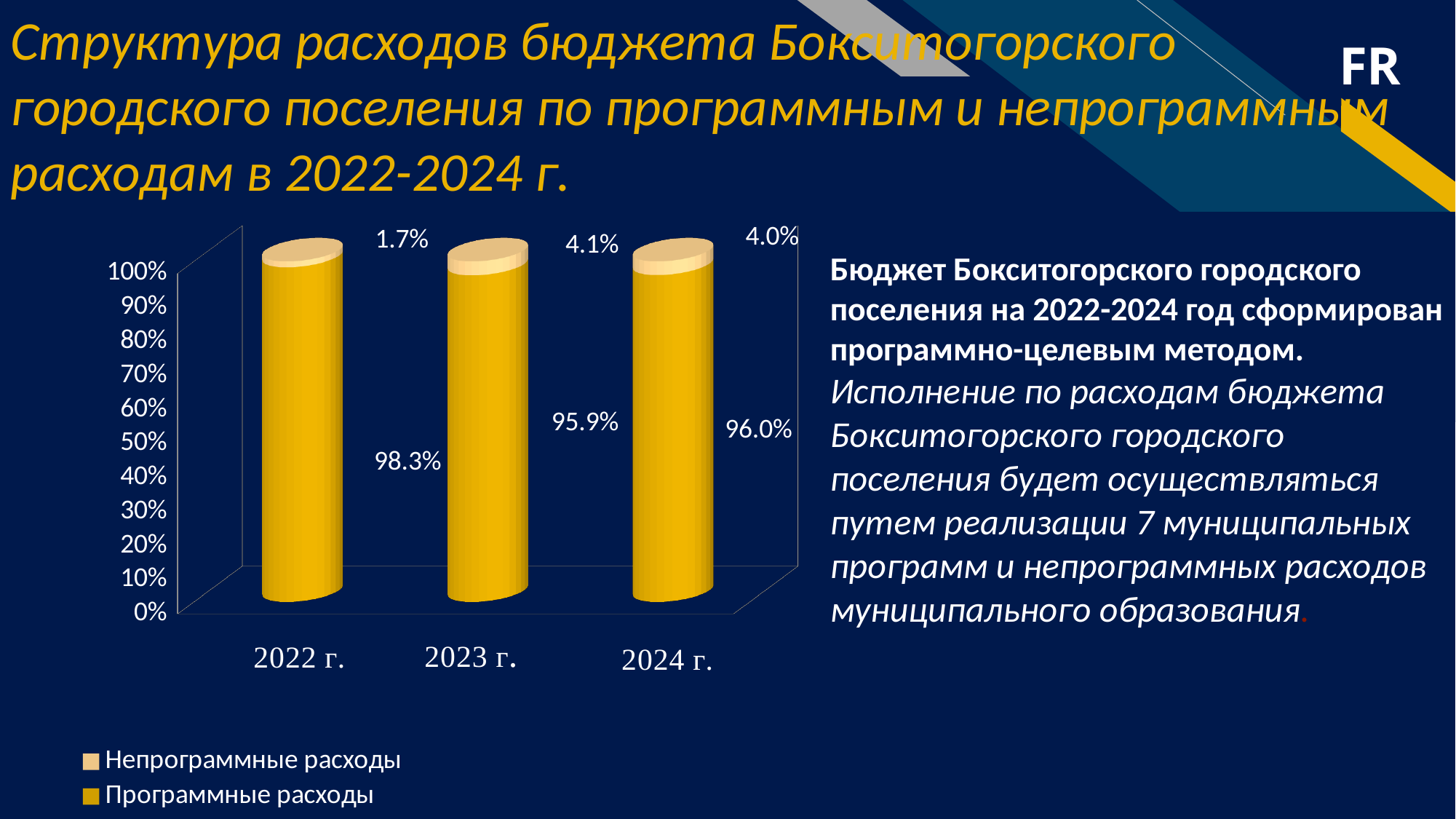
In which year is the share of Непрограммные расходы highest? 2023 г. What kind of chart is shown on the slide? Stacked bar chart How many years are shown on the x axis of the chart? 3 In which year is the share of Программные расходы lowest? 2023 г. What is the value for Непрограммные расходы in 2022 г.? 1.7% What is the value for Программные расходы in 2024 г.? 96.0% What is the total of the stacked bar for 2023 г.? 100% What is the value for Программные расходы in 2022 г.? 98.3% What is the value for Непрограммные расходы in 2023 г.? 4.1% Which is larger: Непрограммные расходы in 2022 г. or in 2024 г.? 2024 г. What is the difference between the Программные расходы values for 2022 г. and 2023 г.? 2.4% How many series does the chart legend list? 2